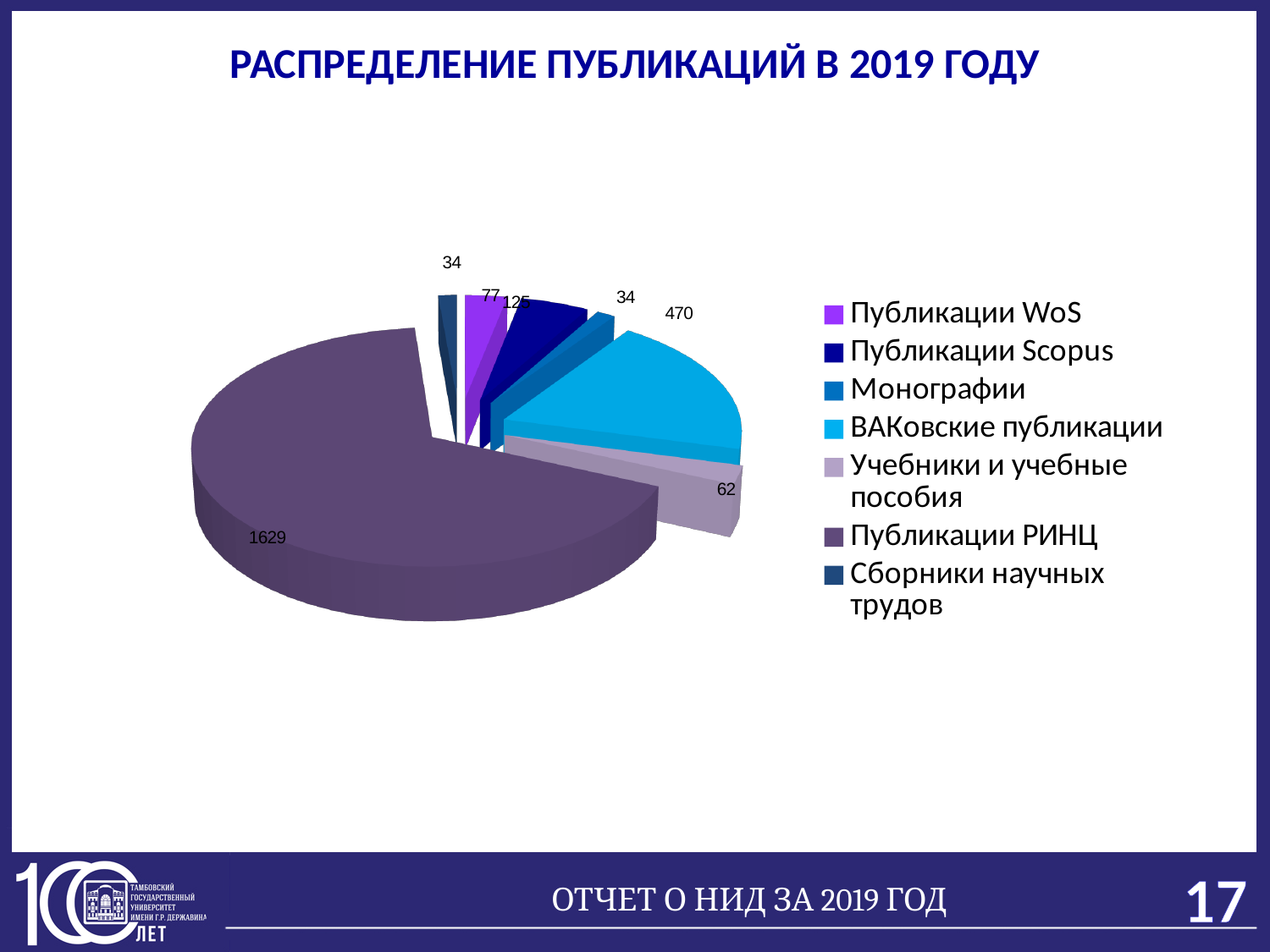
What is the title of the chart on the slide? РАСПРЕДЕЛЕНИЕ ПУБЛИКАЦИЙ В 2019 ГОДУ What is the difference between the values for Публикации Scopus and Публикации WoS? 48 What is the value for Учебники и учебные пособия? 62 What is the value for Публикации Scopus? 125 What is the value for ВАКовские публикации? 470 What is the difference between the values for Публикации РИНЦ and ВАКовские публикации? 1159 What is the value for Публикации WoS? 77 Which category has the largest slice of the pie? Публикации РИНЦ What type of chart is shown on the slide? Pie chart Which is larger, the value for Публикации Scopus or the value for Публикации WoS? Публикации Scopus How many categories does the legend of the pie chart list? 7 What is the value for Публикации РИНЦ? 1629